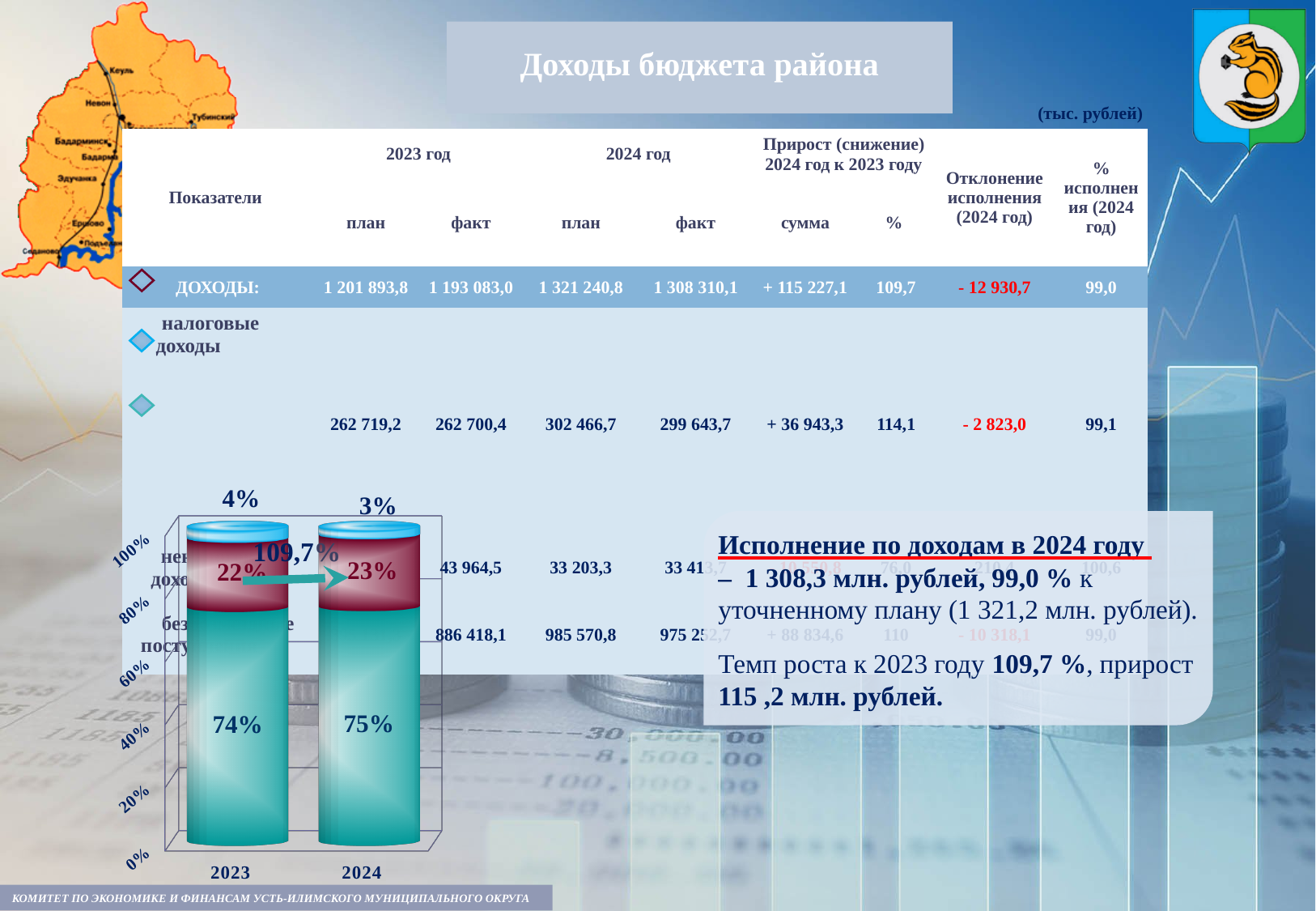
In the bar chart, by how much does the bottom teal segment differ between 2024 and 2023? 1% What kind of chart is shown at the bottom left of the slide? stacked bar chart In the bar chart, what is the value of the top segment for 2024? 3% In the bar chart, what is the value of the bottom teal segment for 2023? 74% What percentage is written on the arrow between the 2023 and 2024 bars? 109,7% In the bar chart, what is the value of the red middle segment for 2023? 22% How many years (categories) are shown on the x axis of the bar chart? 2 In the bar chart, what is the value of the red middle segment for 2024? 23% In the bar chart, is the red middle segment larger in 2023 or in 2024? 2024 In the bar chart, what is the total of the three segments of the 2023 bar? 100% In the bar chart, what is the value of the top segment for 2023? 4% In the bar chart, what is the value of the bottom teal segment for 2024? 75%